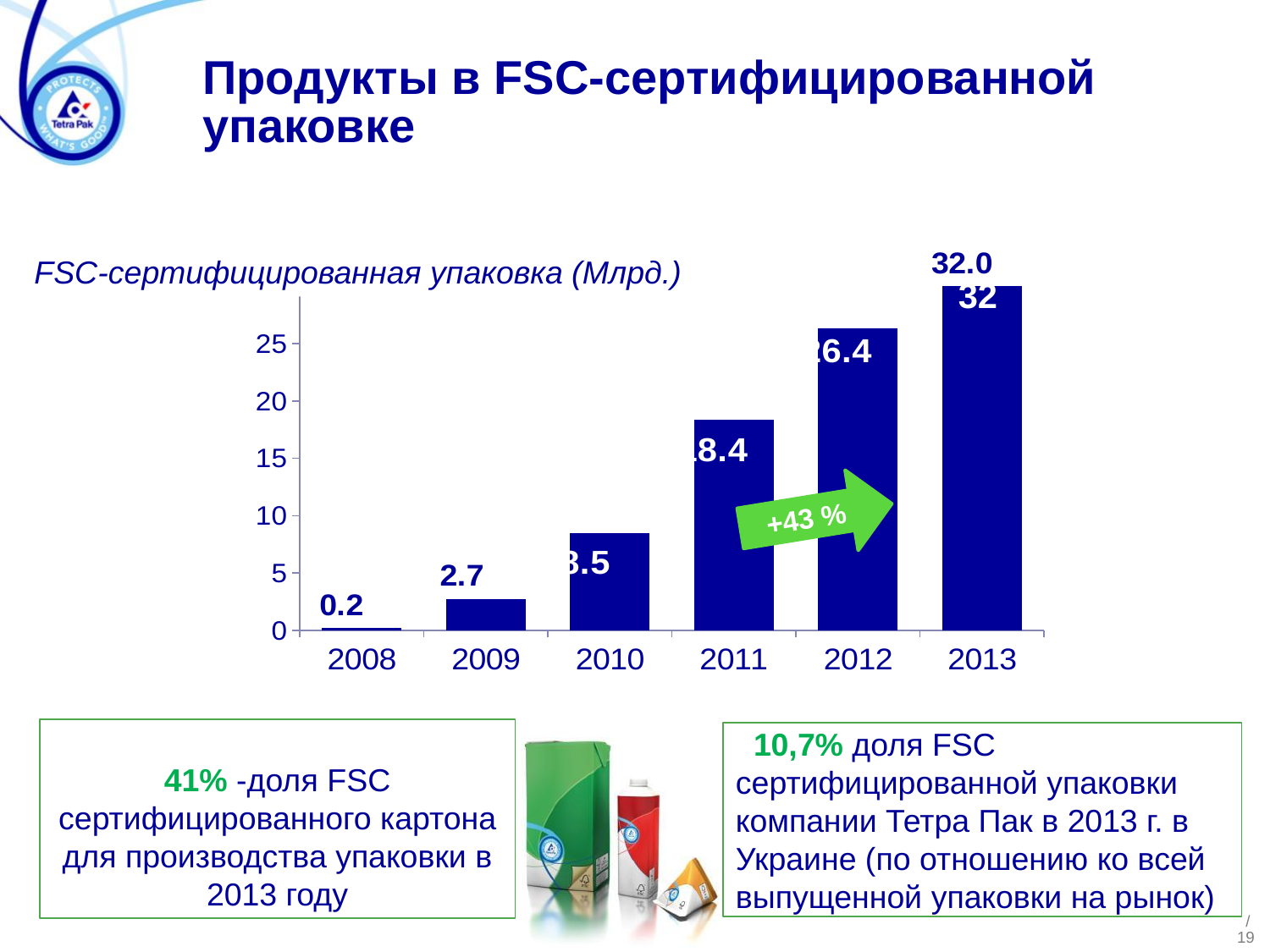
Do the values rise or fall from 2008 to 2013? rise Is the value for 2010 greater or less than 10? less What is the value for 2008 in the chart? 0.2 How many years are shown on the x axis of the chart? 6 Which year has the lowest value in the chart? 2008 What is the value for 2009 in the chart? 2.7 Which year has the highest value in the chart? 2013 What is the difference between the values for 2013 and 2009? 29.3 What percentage is written on the green arrow between the 2011 and 2012 bars? +43 % What is the value for 2013 in the chart? 32.0 Is the value for 2011 greater or less than 15? greater What kind of chart is shown on the slide? bar chart